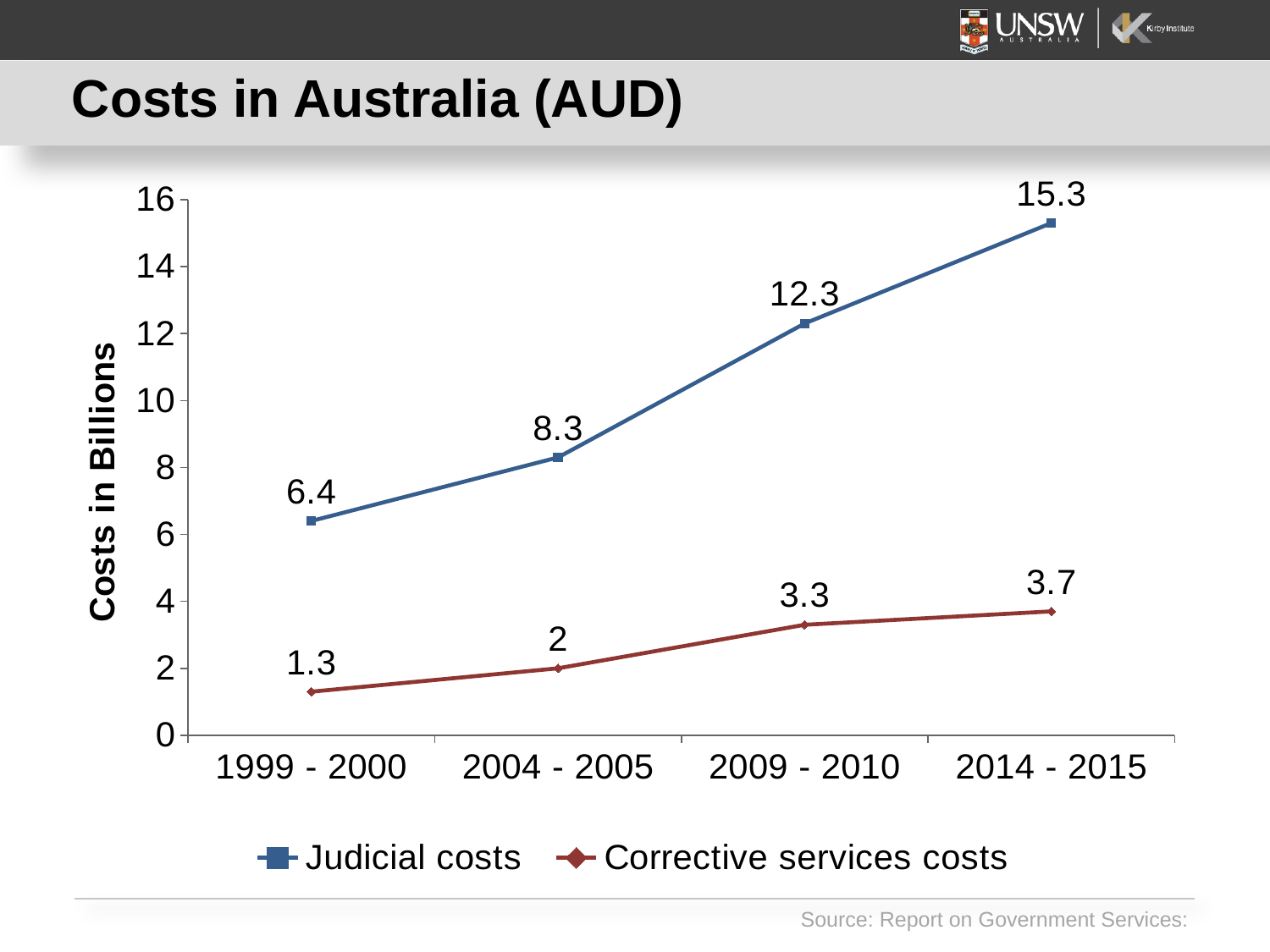
How many series does the legend list? 2 What is the value of Corrective services costs for 2004 - 2005? 2 In which period are Corrective services costs highest? 2014 - 2015 In which period are Judicial costs lowest? 1999 - 2000 Do Judicial costs rise or fall across the periods shown? Rise By how much did Judicial costs increase from 1999 - 2000 to 2014 - 2015? 8.9 Which is larger in 2004 - 2005: Judicial costs or Corrective services costs? Judicial costs What is the value of Judicial costs for 1999 - 2000? 6.4 What is the value of Judicial costs for 2014 - 2015? 15.3 What kind of chart is shown on the slide? Line chart What is the difference between Judicial costs and Corrective services costs in 2009 - 2010? 9 How many time periods are shown on the x axis? 4